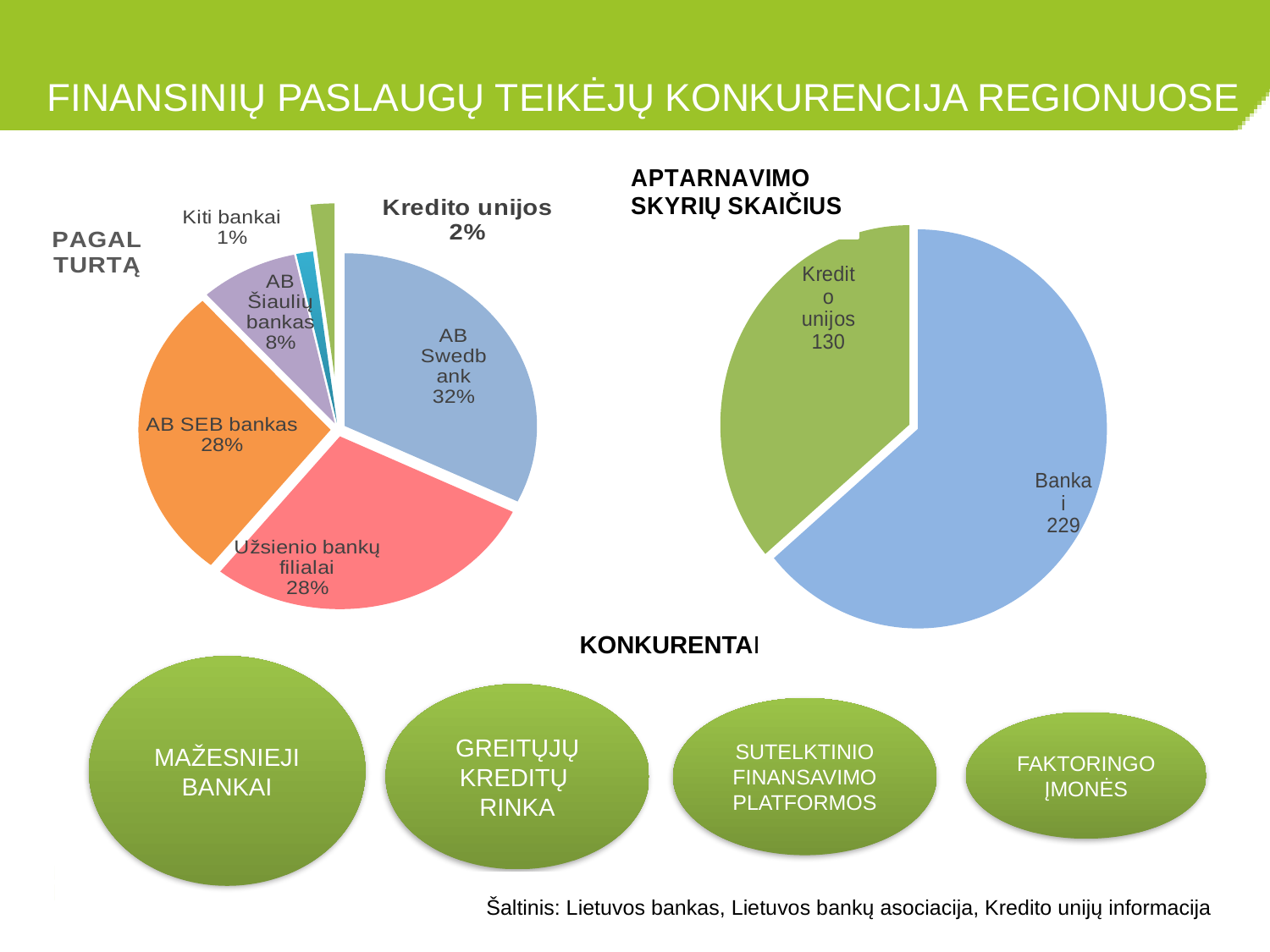
In the 'PAGAL TURTĄ' pie chart, which is larger: the share of AB Šiaulių bankas or the share of Kredito unijos? AB Šiaulių bankas In the 'APTARNAVIMO SKYRIŲ SKAIČIUS' chart, what is the value for Bankai? 229 In the 'PAGAL TURTĄ' pie chart, what share does AB Šiaulių bankas hold? 8% What type of chart is the 'APTARNAVIMO SKYRIŲ SKAIČIUS' chart? Pie chart In the 'PAGAL TURTĄ' pie chart, what is the difference in percentage points between AB Swedbank and AB SEB bankas? 4 In the 'PAGAL TURTĄ' pie chart, which category has the largest share? AB Swedbank In the 'APTARNAVIMO SKYRIŲ SKAIČIUS' chart, what colour is the Bankai slice? Blue How many slices does the 'PAGAL TURTĄ' pie chart have? 6 In the 'PAGAL TURTĄ' pie chart, which category has the smallest share? Kiti bankai In the 'APTARNAVIMO SKYRIŲ SKAIČIUS' chart, what is the value for Kredito unijos? 130 In the 'APTARNAVIMO SKYRIŲ SKAIČIUS' chart, what is the difference between Bankai and Kredito unijos? 99 In the 'PAGAL TURTĄ' pie chart, what share does AB Swedbank hold? 32%